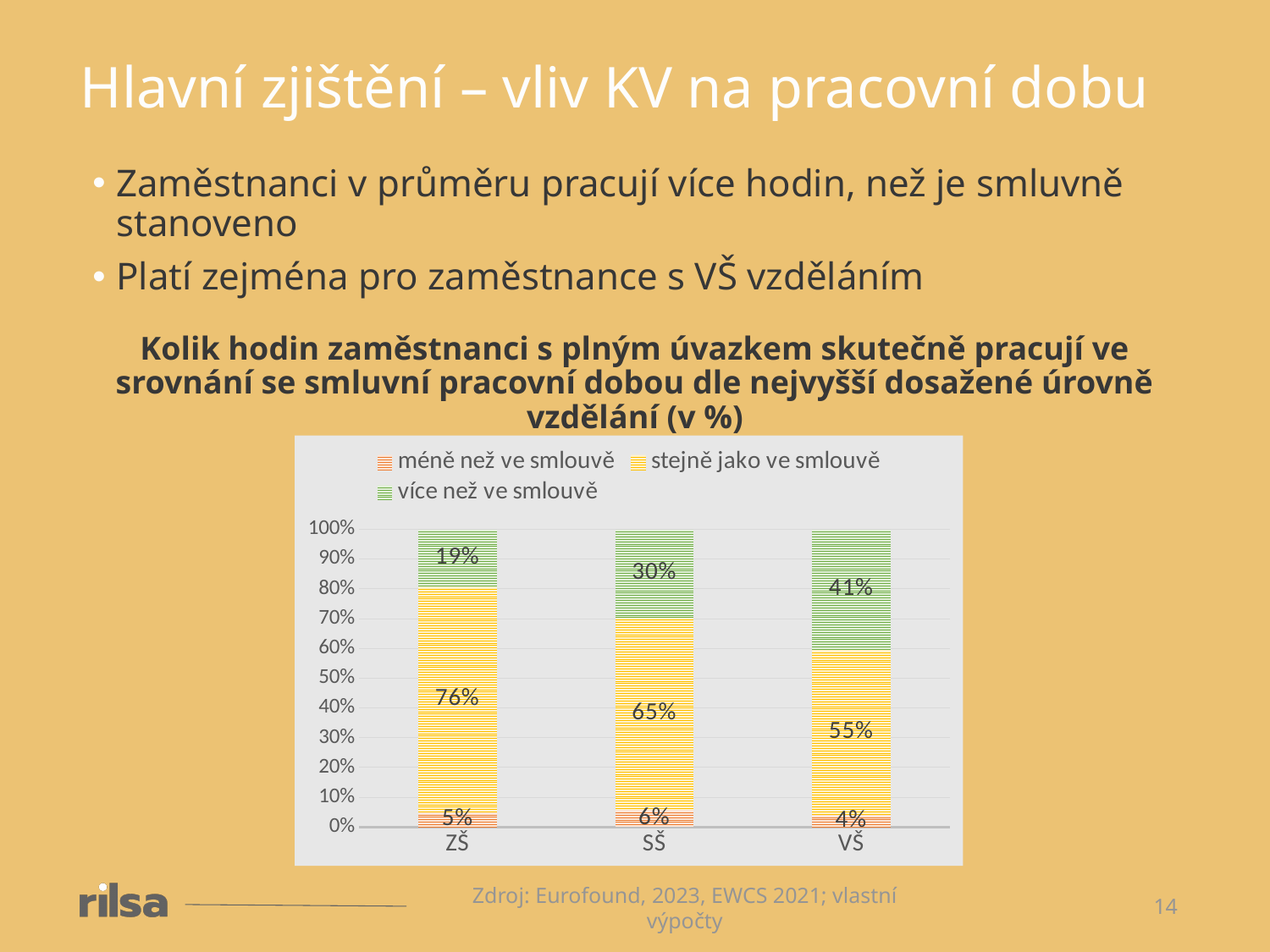
Which education category has the lowest share of 'méně než ve smlouvě'? VŠ What kind of chart is shown on the slide? Stacked bar chart What is the difference between the 'stejně jako ve smlouvě' values for ZŠ and VŠ? 21 percentage points What is the value for 'stejně jako ve smlouvě' for the ZŠ category? 76% What percentage of VŠ employees work more hours than in their contract (více než ve smlouvě)? 41% Which colour represents 'stejně jako ve smlouvě' in the chart? Yellow Which is larger: the 'více než ve smlouvě' share for SŠ or for ZŠ? SŠ How many education categories are shown on the x axis? 3 How does the 'více než ve smlouvě' share change from ZŠ to SŠ to VŠ? It rises What is the value for 'méně než ve smlouvě' for the SŠ category? 6% How many series does the legend list? 3 Which education category has the highest share of 'více než ve smlouvě'? VŠ